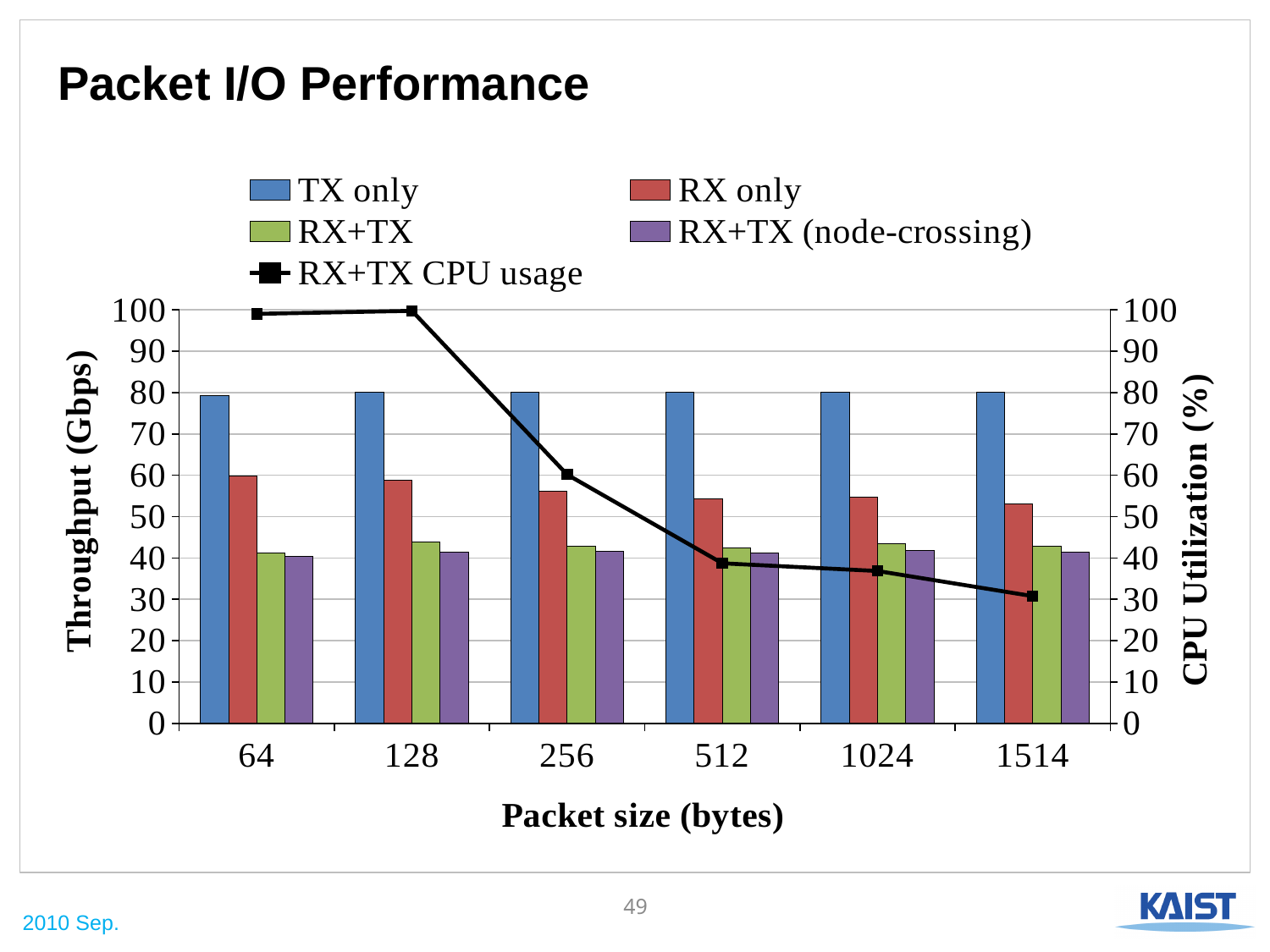
Is the RX+TX CPU usage at packet size 1514 greater or less than 40? less Is the RX+TX throughput at packet size 64 greater or less than 50? less How does the RX+TX CPU usage change as packet size increases? It falls Is the RX only throughput at packet size 64 greater or less than 50? greater How many packet sizes are shown on the x axis? 6 How many series does the legend list? 5 What kind of chart is shown on the slide? A bar chart combined with a line At which packet size is the RX+TX CPU usage lowest? 1514 Which series has the highest throughput at packet size 64? TX only What is the label of the right-hand y axis? CPU Utilization (%)